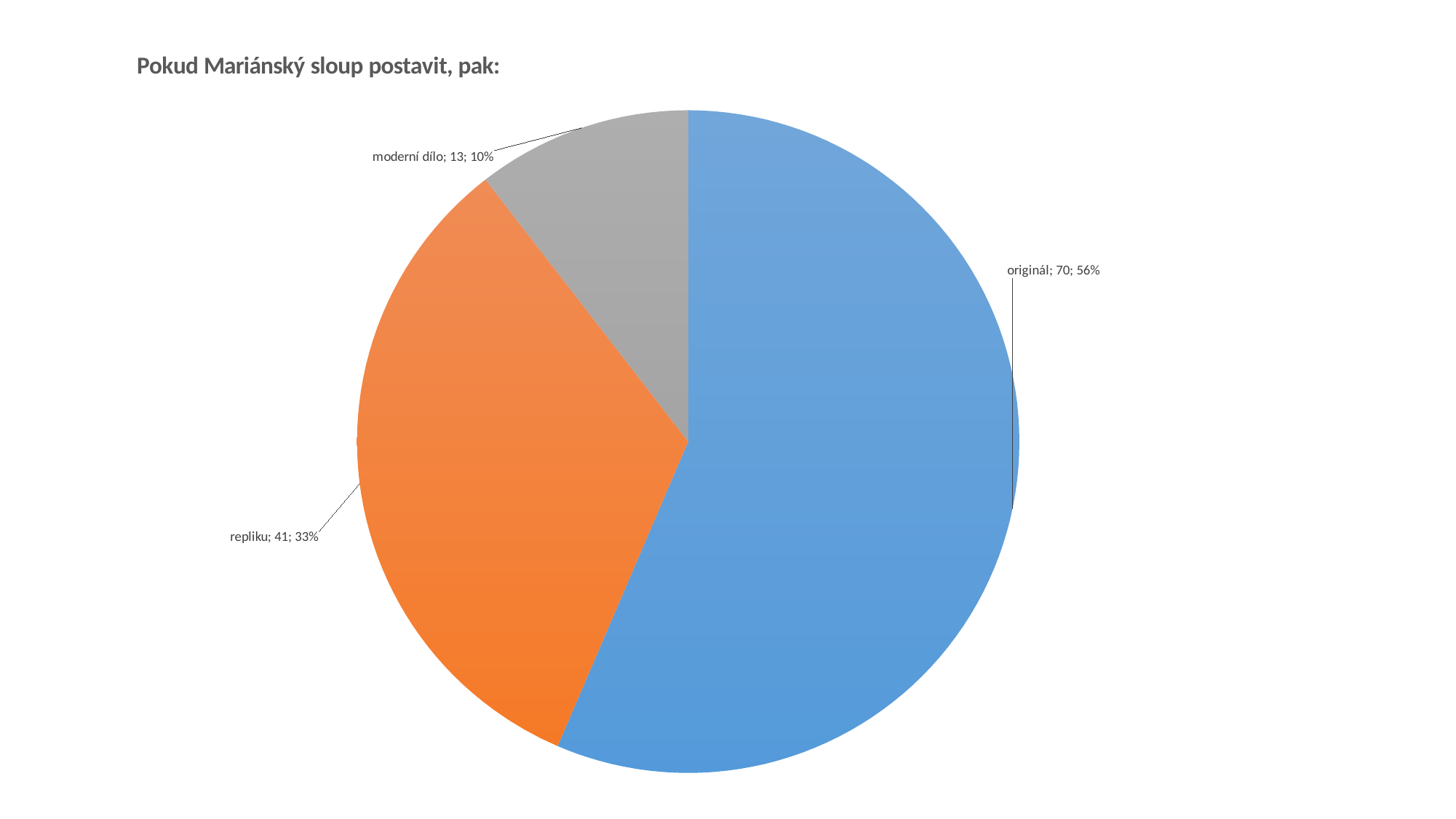
What is the value for 'originál'? 70 What is the difference between the values for 'originál' and 'repliku'? 29 What share of the pie does 'repliku' represent? 33% What is the title of the chart? Pokud Mariánský sloup postavit, pak: What is the value for 'moderní dílo'? 13 What share of the pie does 'moderní dílo' represent? 10% How many slices does the pie chart have? 3 What kind of chart is shown on the slide? pie chart What share of the pie does 'originál' represent? 56% Which category has the largest slice? originál What is the value for 'repliku'? 41 Which category has the smallest slice? moderní dílo